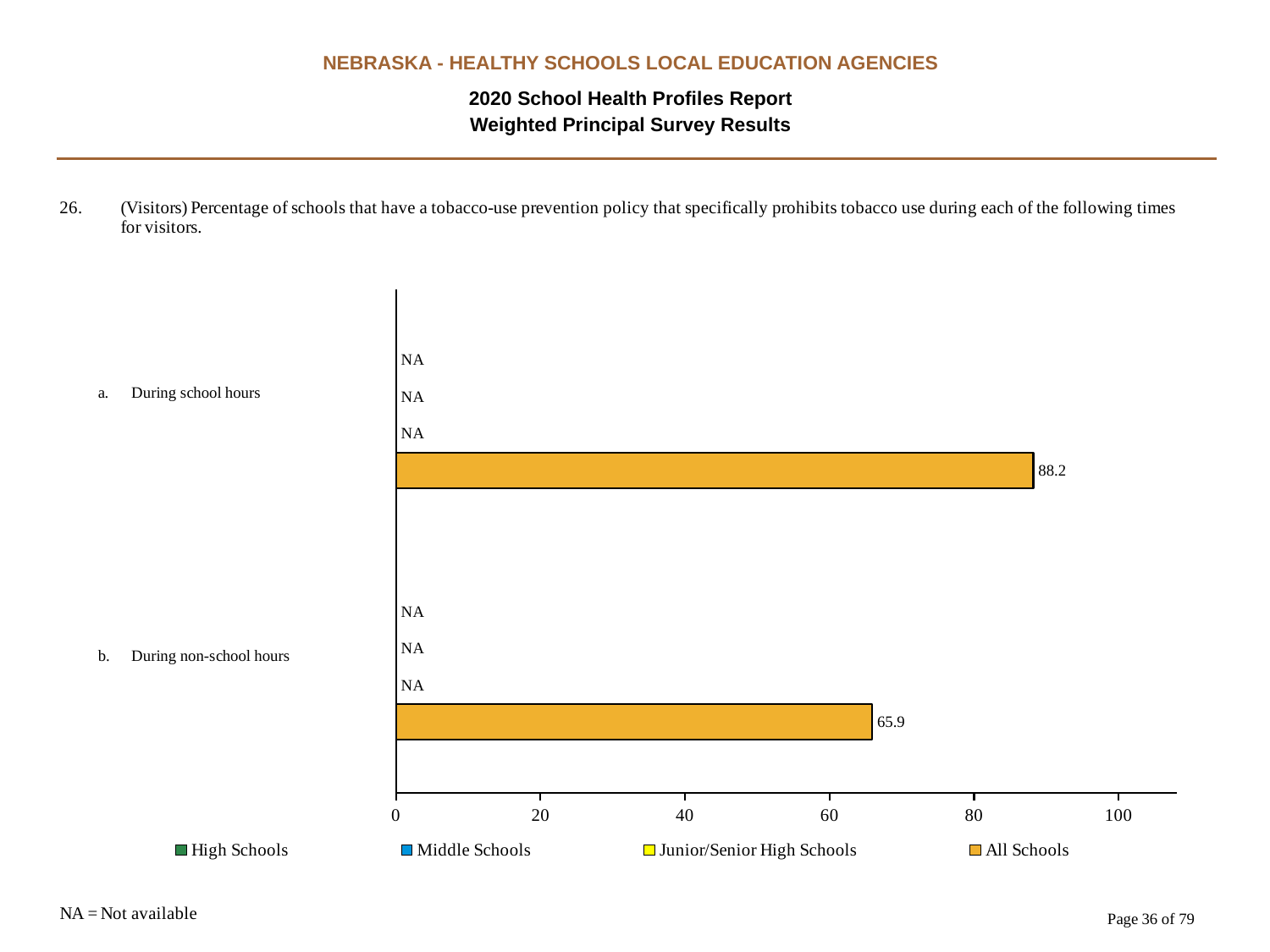
What is the value for All Schools for 'During non-school hours'? 65.9 How many series does the legend list? 4 What kind of chart is shown on the slide? bar chart What value is shown for High Schools for 'During school hours'? NA What does NA stand for according to the note on the slide? Not available What value is shown for Middle Schools for 'During non-school hours'? NA Is the All Schools value for 'During non-school hours' greater or less than 60? greater What is the difference between the All Schools values for 'During school hours' and 'During non-school hours'? 22.3 How many categories are shown on the chart? 2 What is the value for All Schools for 'During school hours'? 88.2 Is the All Schools value for 'During school hours' greater or less than 80? greater Which category has the higher All Schools value, 'During school hours' or 'During non-school hours'? During school hours